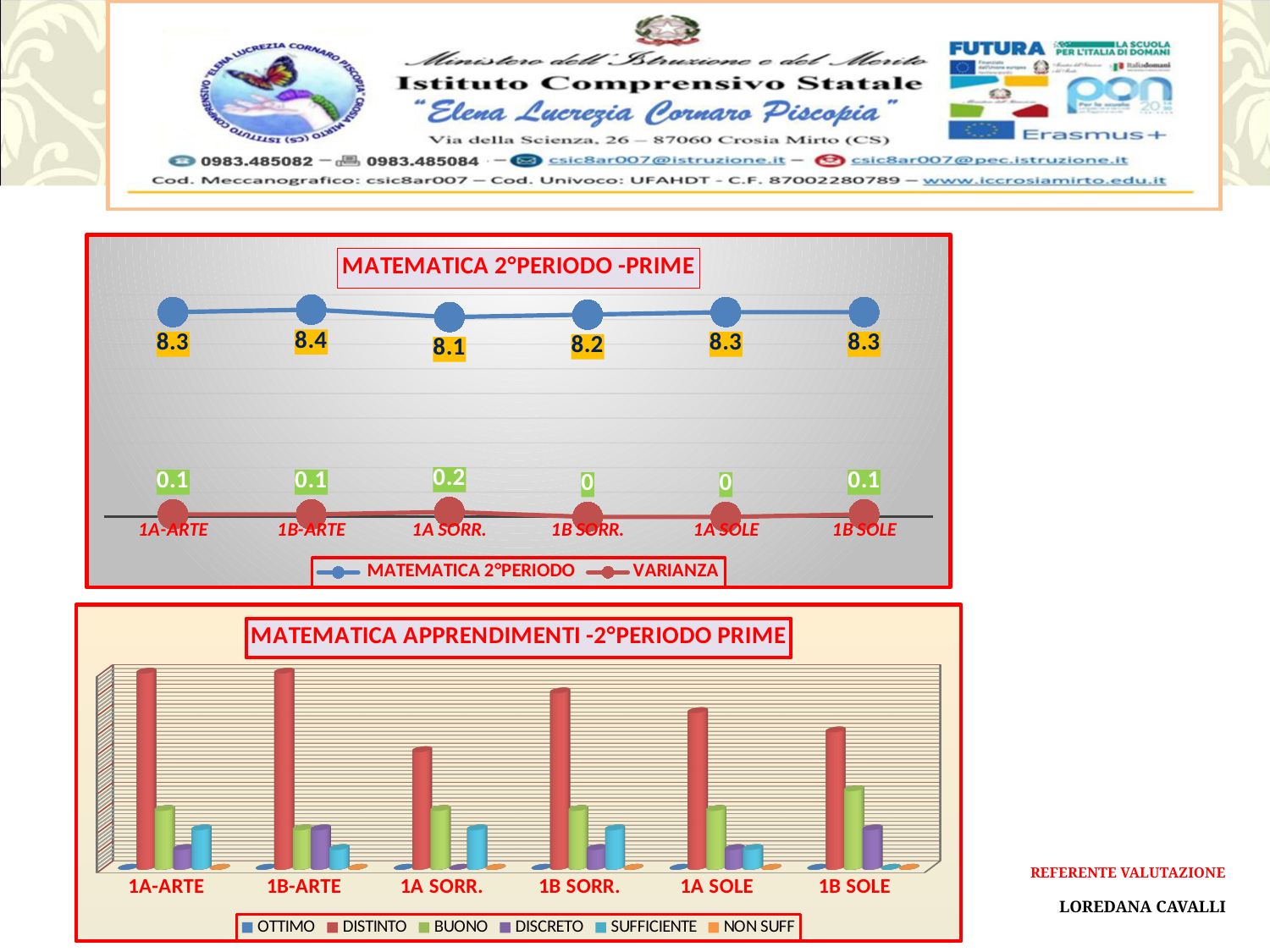
In the chart titled 'MATEMATICA 2°PERIODO -PRIME', which category has the lowest MATEMATICA 2°PERIODO value? 1A SORR. In the chart titled 'MATEMATICA 2°PERIODO -PRIME', which has the larger VARIANZA value, 1A SORR. or 1B SORR.? 1A SORR. What kind of chart is the one titled 'MATEMATICA 2°PERIODO -PRIME'? Line chart In the chart titled 'MATEMATICA 2°PERIODO -PRIME', what is the VARIANZA value for 1A SORR.? 0.2 In the chart titled 'MATEMATICA 2°PERIODO -PRIME', what is the MATEMATICA 2°PERIODO value for 1B-ARTE? 8.4 In the chart titled 'MATEMATICA 2°PERIODO -PRIME', how many series does the legend list? 2 In the chart titled 'MATEMATICA 2°PERIODO -PRIME', what is the difference between the MATEMATICA 2°PERIODO values for 1B-ARTE and 1A SORR.? 0.3 What kind of chart is the one titled 'MATEMATICA APPRENDIMENTI -2°PERIODO PRIME'? Bar chart In the chart titled 'MATEMATICA 2°PERIODO -PRIME', which category has the highest MATEMATICA 2°PERIODO value? 1B-ARTE In the chart titled 'MATEMATICA APPRENDIMENTI -2°PERIODO PRIME', how many series does the legend list? 6 In the chart titled 'MATEMATICA APPRENDIMENTI -2°PERIODO PRIME', which series has the tallest bar for 1A-ARTE? DISTINTO In the chart titled 'MATEMATICA 2°PERIODO -PRIME', how many categories are shown on the x axis? 6